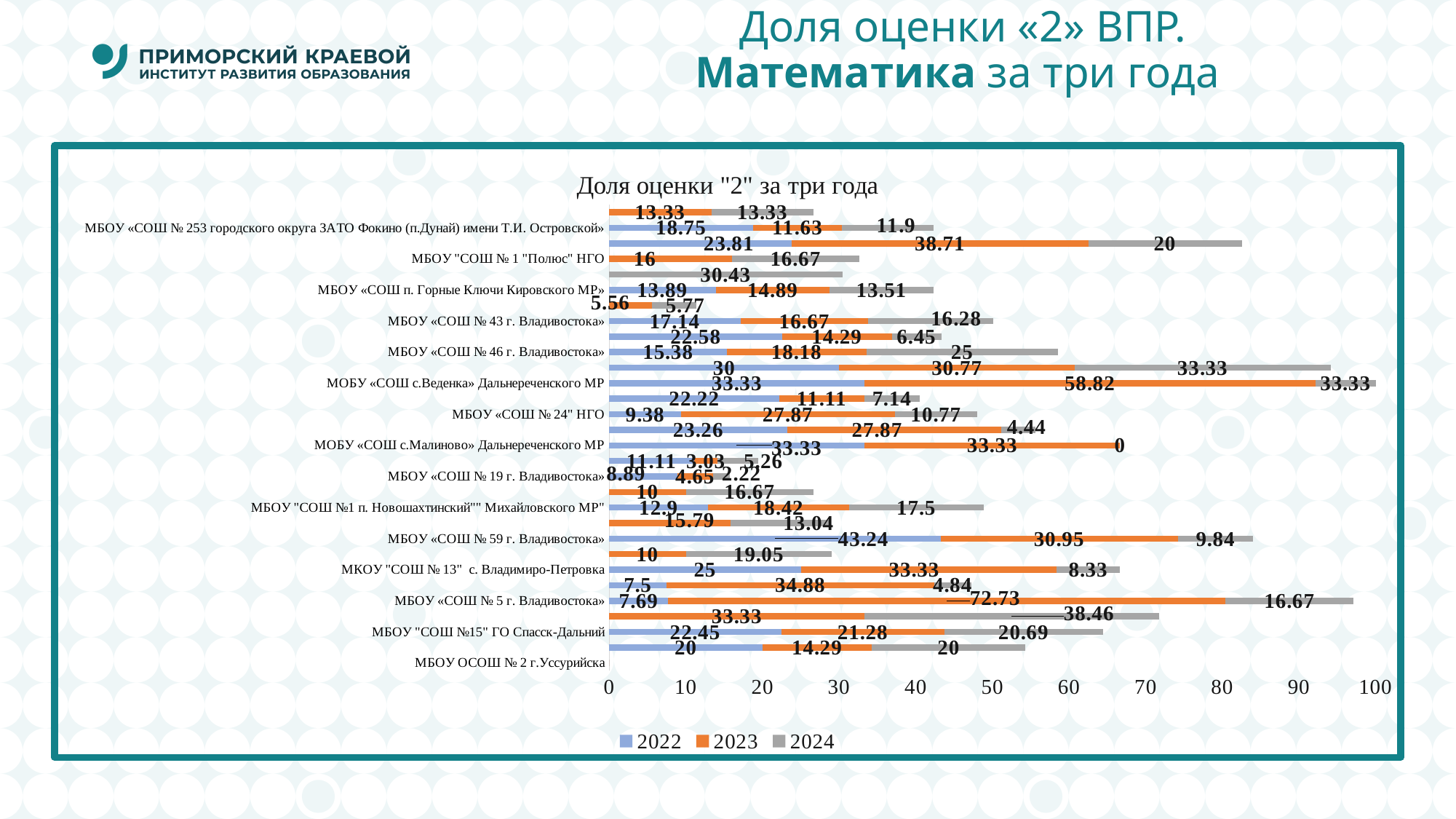
What is the 2022 value for МБОУ «СОШ № 24" НГО? 9.38 For МБОУ «СОШ № 46 г. Владивостока», which is larger: the 2023 value or the 2024 value? 2024 For МБОУ «СОШ № 5 г. Владивостока», what is the difference between the 2023 value and the 2024 value? 56.06 What is the 2023 value for МОБУ «СОШ с.Веденка» Дальнереченского МР? 58.82 What is the 2023 value for МБОУ «СОШ № 5 г. Владивостока»? 72.73 What kind of chart is shown on the slide? bar chart What is the 2022 value for МБОУ «СОШ № 59 г. Владивостока»? 43.24 What is the 2024 value for МОБУ «СОШ с.Малиново» Дальнереченского МР? 0 What is the total of the stacked bar for МБОУ «СОШ № 43 г. Владивостока» across 2022, 2023 and 2024? 50.09 What are the legend entries of the chart? 2022, 2023, 2024 What is the title of the chart? Доля оценки "2" за три года How many series does the legend list? 3